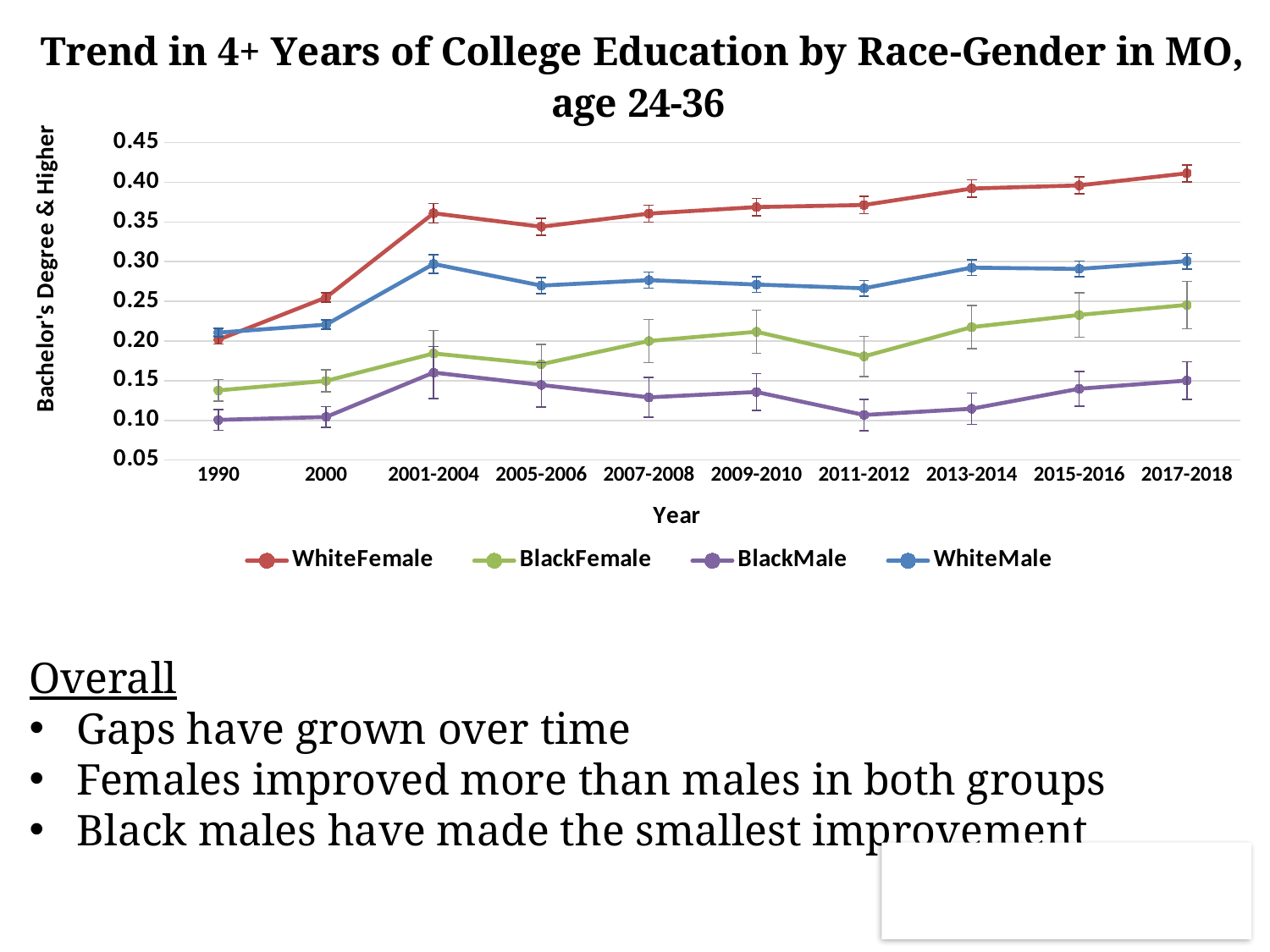
What is the title of the y axis? Bachelor's Degree & Higher Which is larger in 2017-2018, BlackFemale or BlackMale? BlackFemale How many year categories are shown on the x axis? 10 In which year is the WhiteFemale series at its highest? 2017-2018 Which series has the lowest value in 1990? BlackMale Which series has the highest value in 2017-2018? WhiteFemale Does the WhiteFemale series rise or fall from 1990 to 2017-2018? rise Is the value for WhiteFemale in 2017-2018 greater or less than 0.40? greater What kind of chart is shown on the slide? line chart How many series does the legend list? 4 Is the value for WhiteMale in 2001-2004 greater or less than 0.25? greater Is the value for BlackMale in 1990 greater or less than 0.15? less